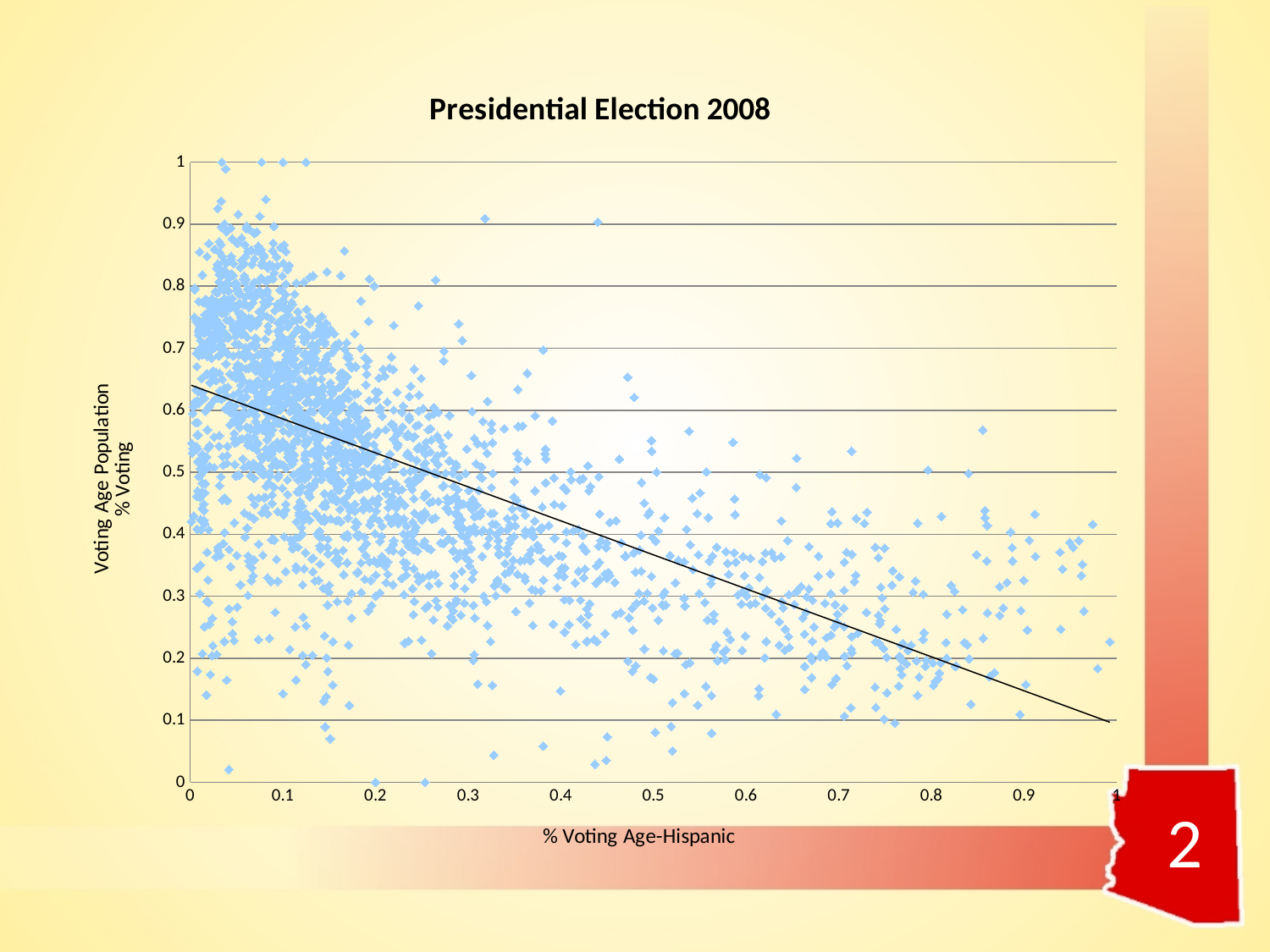
What kind of chart is shown on the slide? scatter plot Is the value of the trend line at x = 0.9 greater or less than 0.3? less What is the highest value shown on the y axis? 1 What is the lowest value shown on the x axis? 0 How many tick labels are shown on the x axis? 11 What is the label of the x axis? % Voting Age-Hispanic As % Voting Age-Hispanic increases along the x axis, does the trend line rise or fall? fall Is the value of the trend line at x = 0.5 greater or less than 0.5? less Is the value of the trend line at x = 0 greater or less than 0.5? greater What is the title of the chart? Presidential Election 2008 Is the trend line value at x = 0 larger or smaller than its value at x = 1? larger